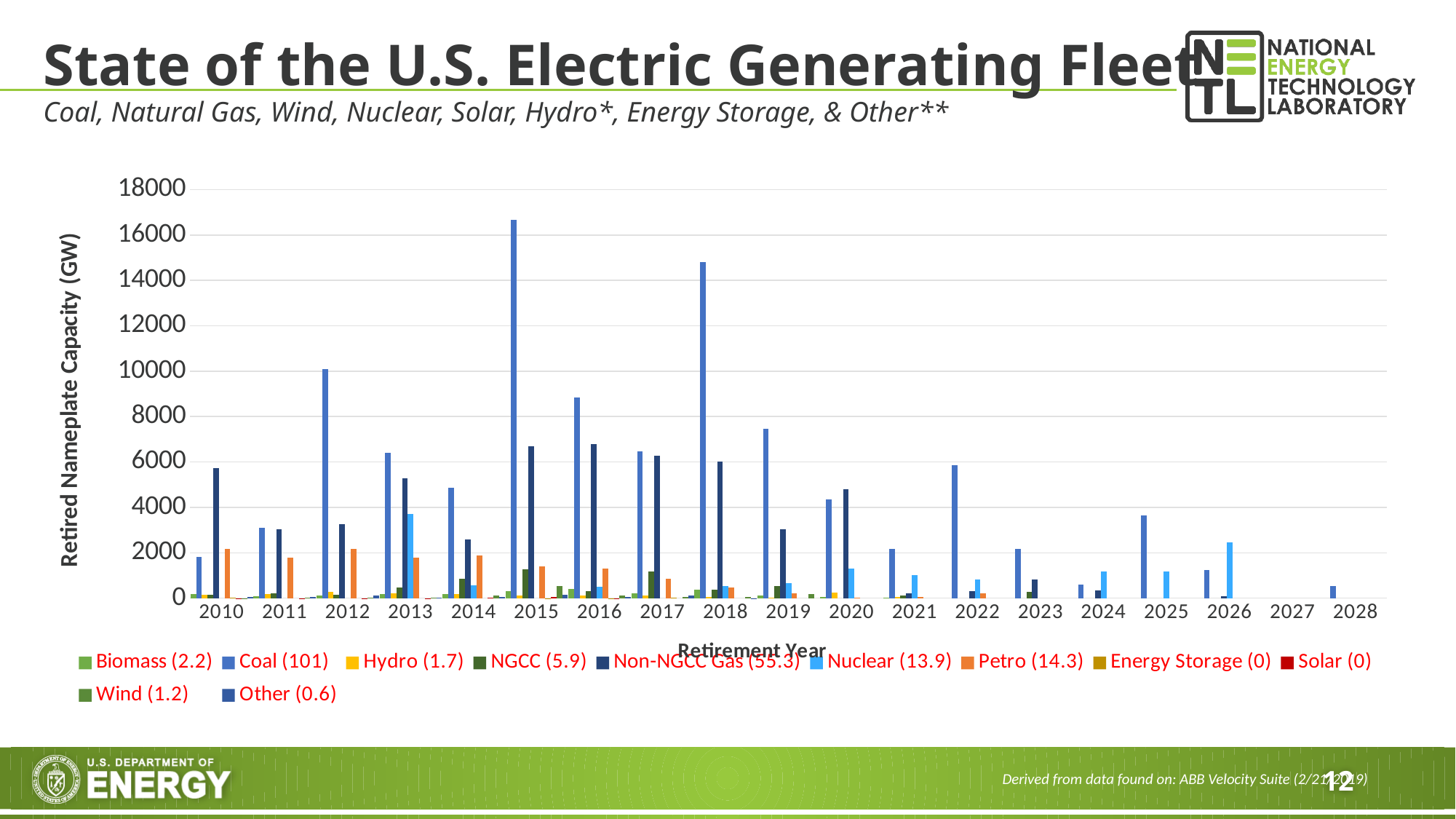
How many retirement years are shown along the x axis? 19 How many series does the legend list? 11 Is the Non-NGCC Gas value for 2010 greater or less than 6000? less Which series has the tallest bar in 2010? Non-NGCC Gas In which retirement year does the tallest bar on the chart appear? 2015 Is the Coal value for 2018 greater or less than 14000? greater What kind of chart is shown on the slide? bar chart Is the Nuclear value for 2013 greater or less than 2000? greater Which is larger, the Nuclear value for 2025 or the Nuclear value for 2026? 2026 Which is larger, the Coal value for 2012 or the Coal value for 2013? 2012 What is the title of the y axis? Retired Nameplate Capacity (GW)